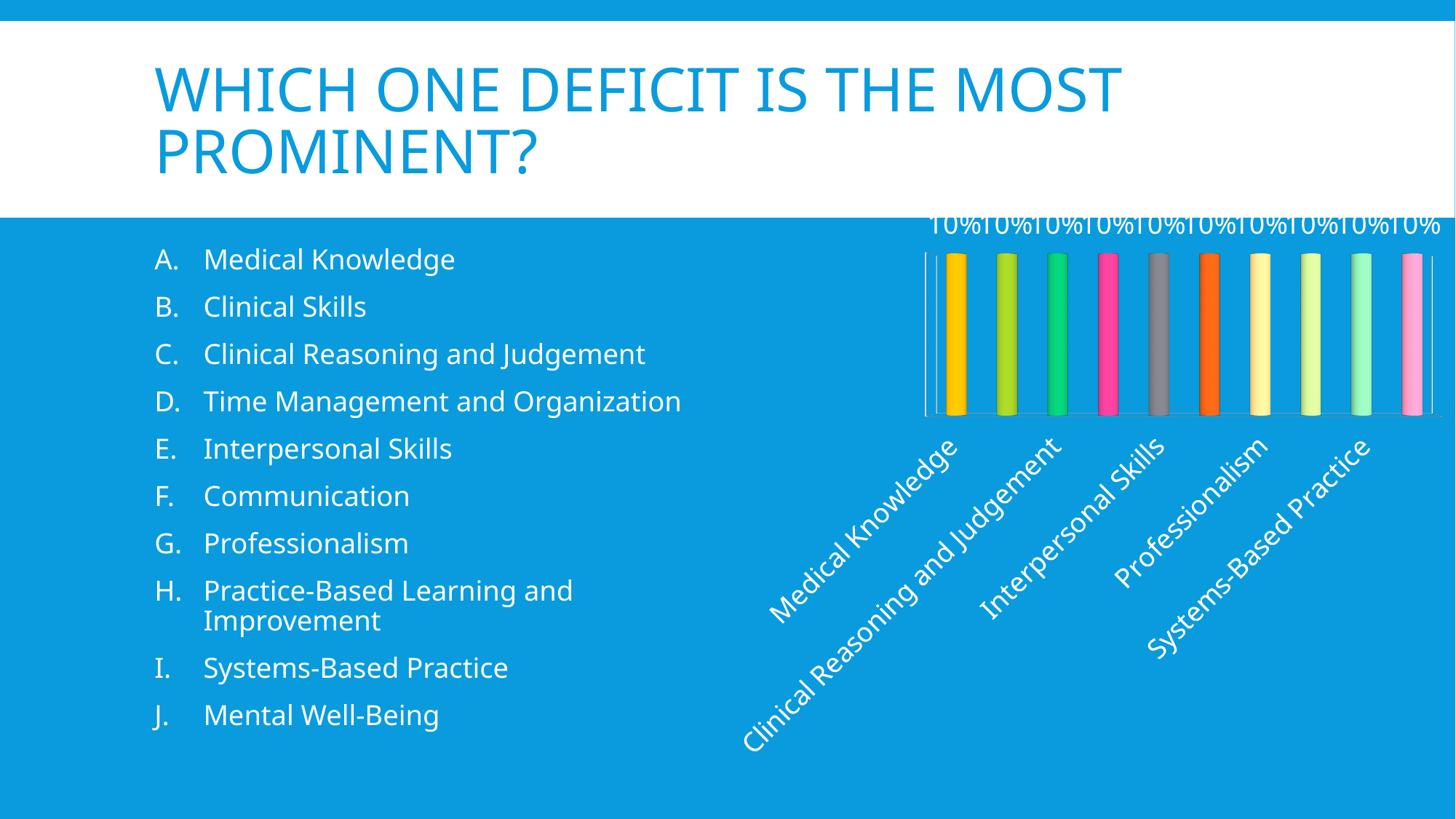
What kind of chart is shown on the slide? Bar chart What is the value shown for Professionalism? 10% Is the value for Interpersonal Skills larger than, smaller than, or equal to the value for Systems-Based Practice? Equal What is the difference between the values for Clinical Reasoning and Judgement and Interpersonal Skills? 0% What is the title of the slide containing the chart? Which one deficit is the most prominent? How many bars are plotted in the chart? 10 What is the difference between the values for Medical Knowledge and Professionalism? 0% What is the value shown for Medical Knowledge? 10% What is the value shown for Clinical Reasoning and Judgement? 10% What is the value shown for Systems-Based Practice? 10% What is the value shown for Interpersonal Skills? 10% Do the values rise, fall, or stay the same across the categories from left to right? Stay the same